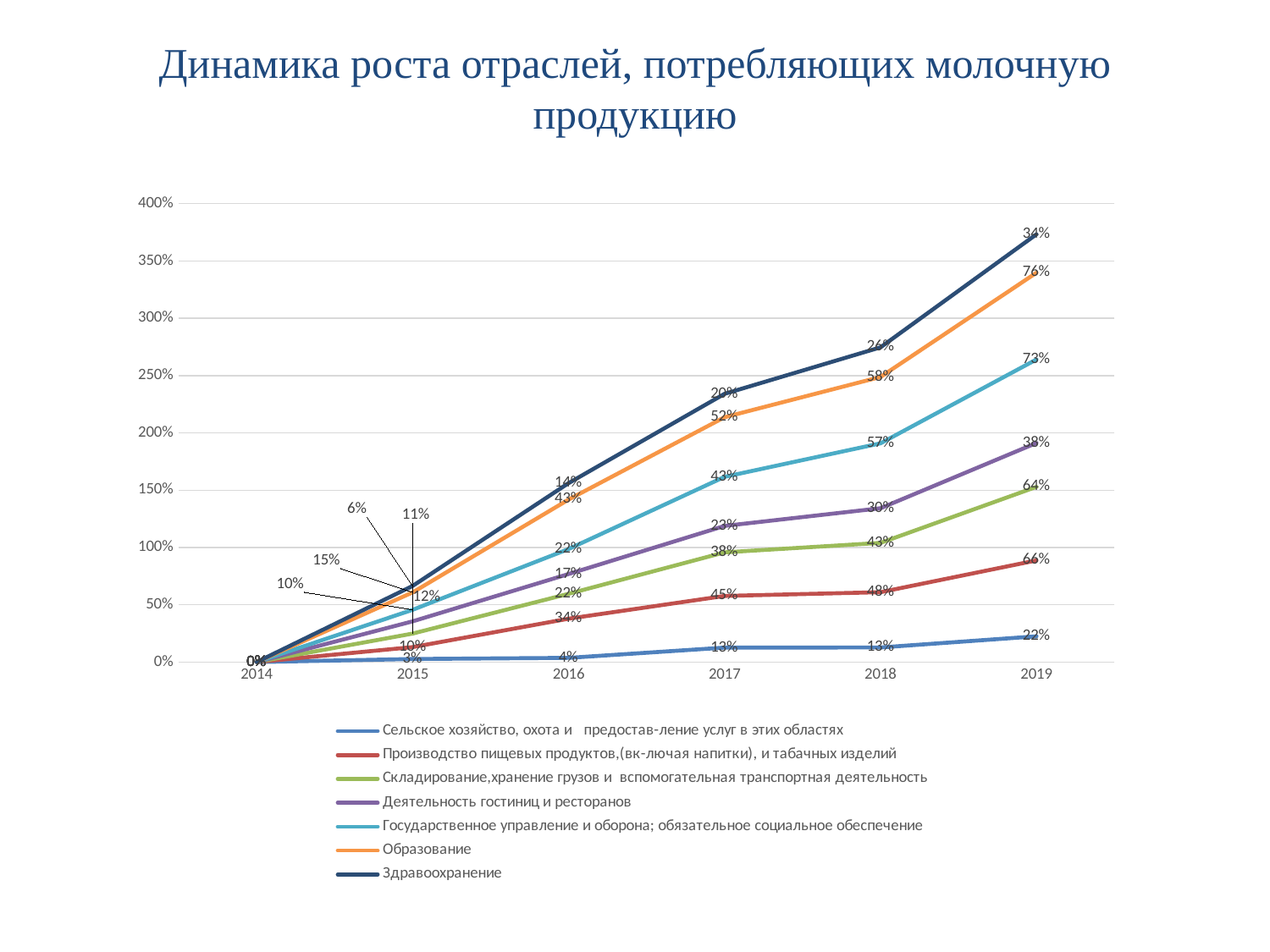
Is the value for Сельское хозяйство, охота и предостав-ление услуг в этих областях in 2019 greater or less than 50%? less Is the value for Образование in 2019 greater or less than 300%? less What kind of chart is shown on the slide? line chart Which series has the lowest value in 2019? Сельское хозяйство, охота и предостав-ление услуг в этих областях Is the value for Здравоохранение in 2019 greater or less than 350%? less How many years are shown along the x axis? 6 What is the title of the chart? Динамика роста отраслей, потребляющих молочную продукцию In 2019, which is larger: Образование or Государственное управление и оборона; обязательное социальное обеспечение? Образование How many series does the legend list? 7 Which series has the highest value in 2019? Образование Does the line for Здравоохранение rise or fall from 2014 to 2019? rise